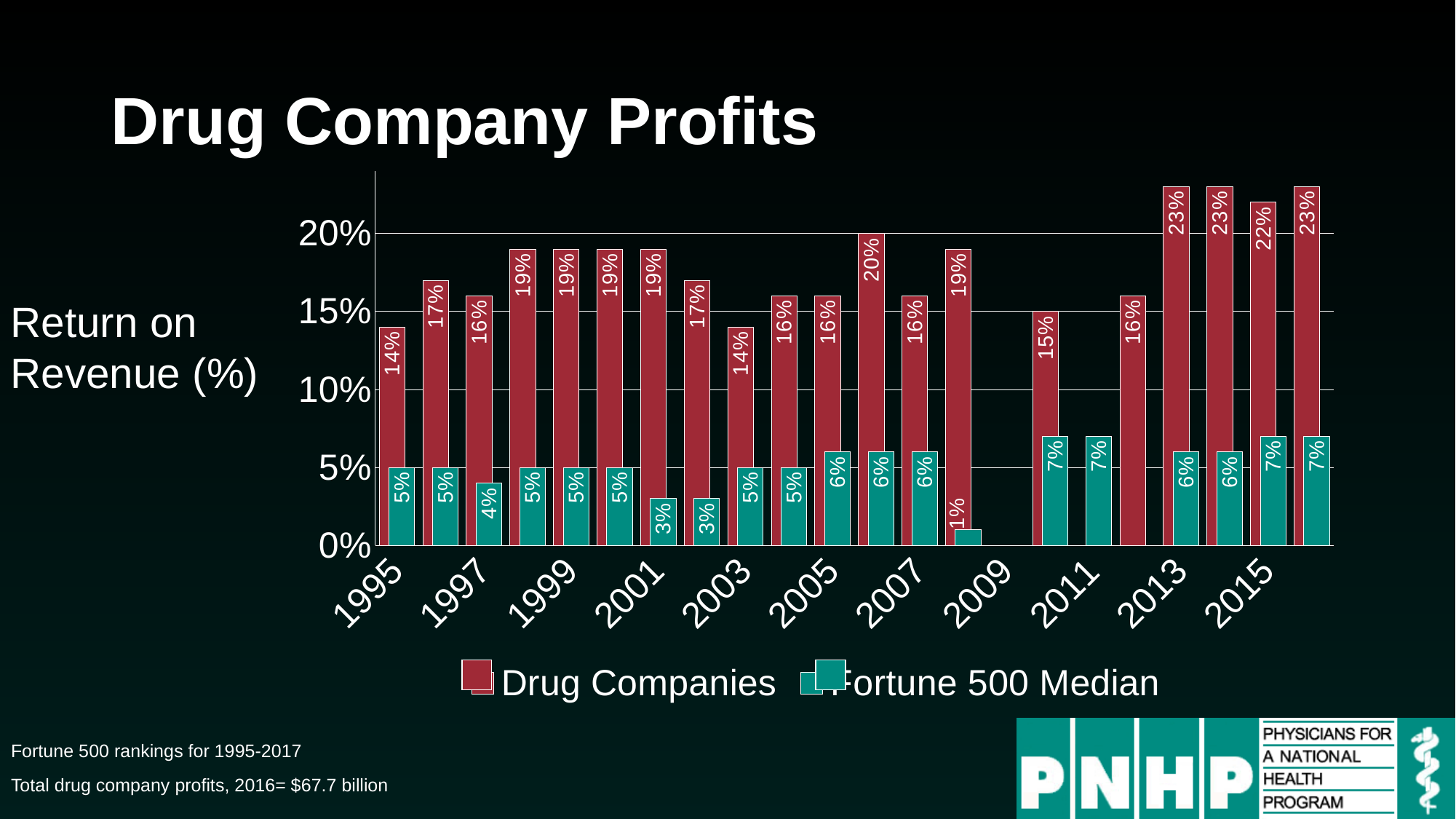
What is the Fortune 500 Median return on revenue in 1997? 4% Is the Drug Companies value for 2015 greater or less than 20%? greater What is the return on revenue for Drug Companies in 2013? 23% What is the highest return on revenue shown for Drug Companies? 23% Which is larger in 2001: the Drug Companies value or the Fortune 500 Median value? Drug Companies What is the return on revenue for Drug Companies in 1995? 14% What is the title of the chart? Drug Company Profits In 2013, how many percentage points higher is the Drug Companies value than the Fortune 500 Median? 17 percentage points How many series does the legend list? 2 What type of chart is shown on the slide? bar chart What is the lowest return on revenue shown for the Fortune 500 Median? 1% What is the Fortune 500 Median return on revenue in 2015? 7%